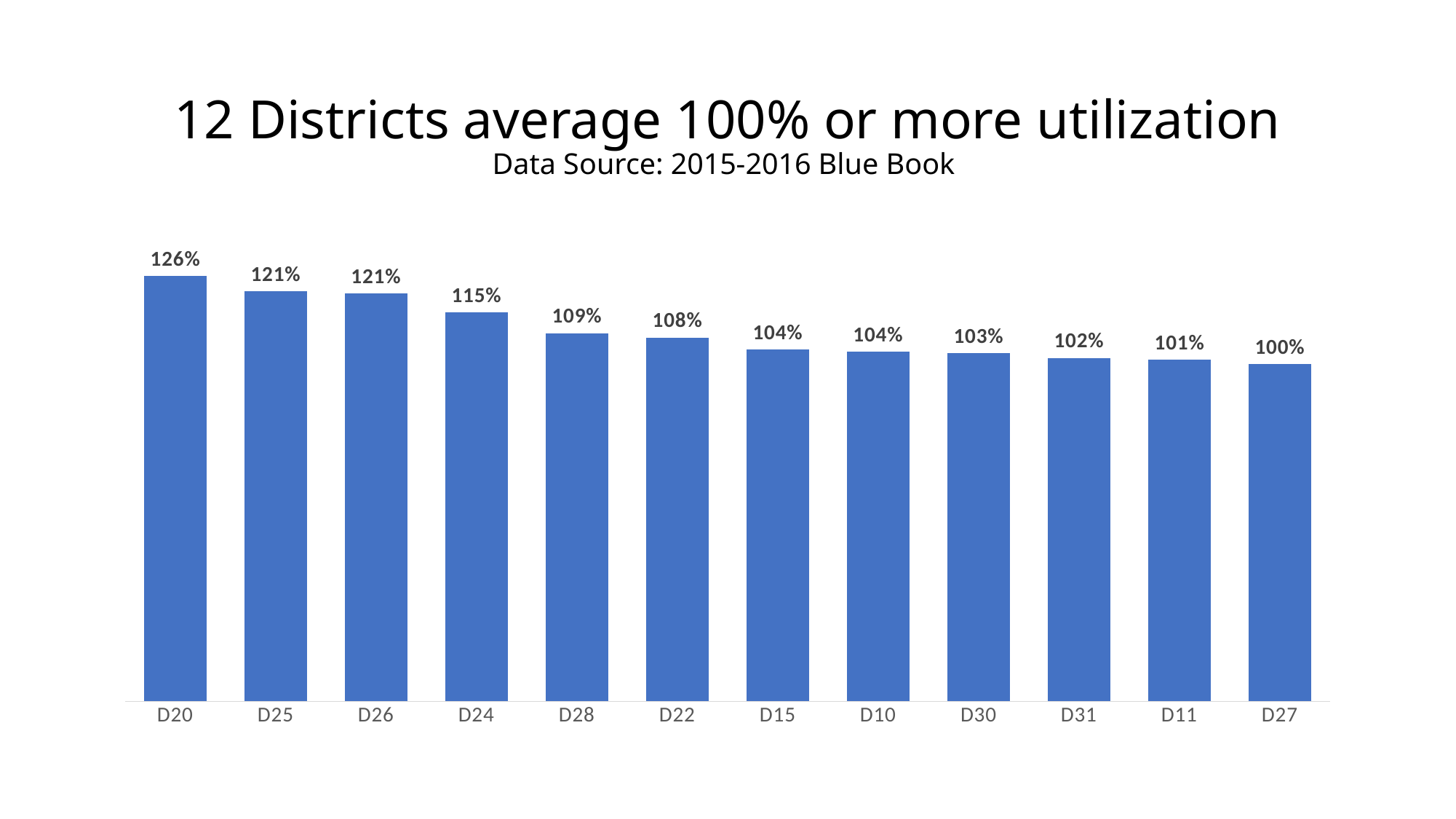
Which has a higher utilization, D24 or D30? D24 What data source is cited under the chart title? 2015-2016 Blue Book What is the utilization value for D27? 100% Which district has the lowest utilization? D27 How many districts are shown in the chart? 12 What is the utilization value for D20? 126% Do the values rise or fall from left to right along the x axis? Fall Which district has the highest utilization? D20 What kind of chart is shown on the slide? Bar chart What is the utilization value for D28? 109% What is the difference between the utilization of D20 and D24? 11% What is the difference between the utilization of D22 and D27? 8%